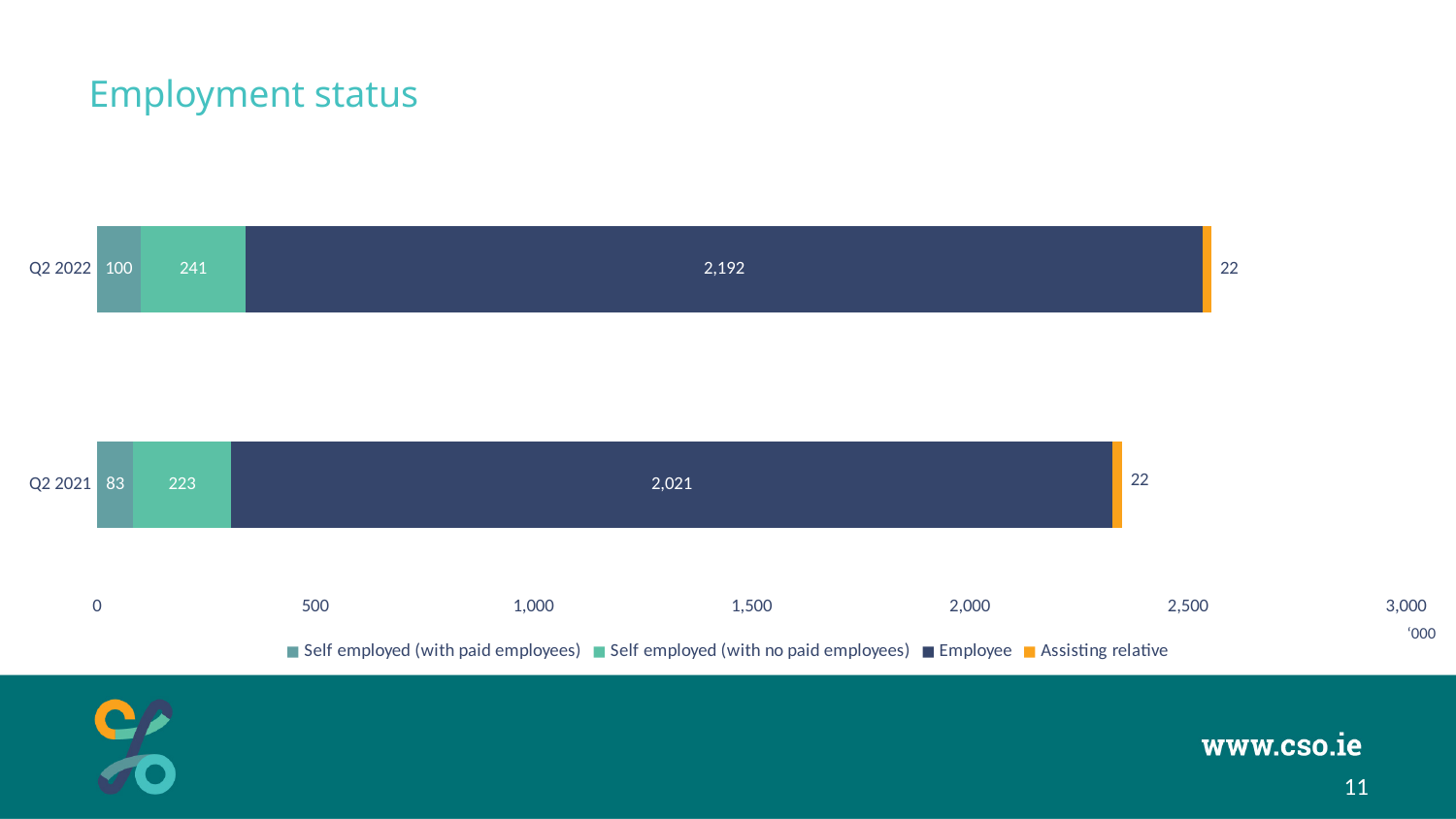
What is the difference between the Self employed (with no paid employees) values for Q2 2022 and Q2 2021? 18 What kind of chart is shown on the slide? Stacked bar chart Which period has the larger Self employed (with paid employees) value, Q2 2022 or Q2 2021? Q2 2022 What is the Self employed (with no paid employees) value for Q2 2022? 241 What is the total of the stacked bar for Q2 2021? 2,349 What is the Assisting relative value for Q2 2021? 22 How many categories (periods) are shown on the chart? 2 What is the Employee value for Q2 2022? 2,192 How many series does the legend list? 4 What is the total of the stacked bar for Q2 2022? 2,555 What is the Self employed (with paid employees) value for Q2 2021? 83 What is the difference between the Employee values for Q2 2022 and Q2 2021? 171